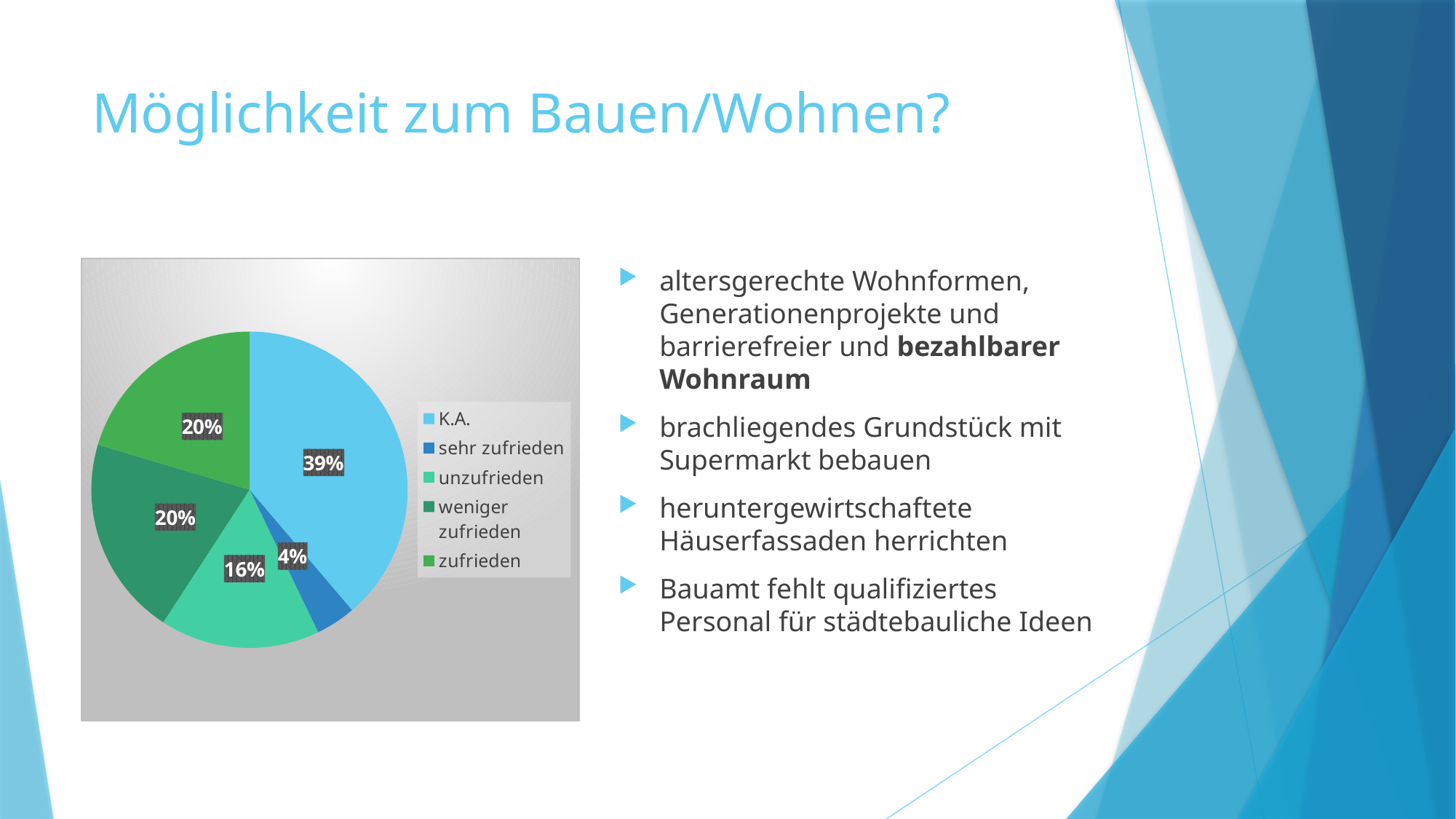
Which category has the largest slice of the pie chart? K.A. Which slice is larger, 'unzufrieden' or 'sehr zufrieden'? unzufrieden How many categories does the pie chart legend list? 5 What type of chart is shown on the slide? pie chart What percentage of the pie chart is labelled K.A.? 39% Which category has the smallest slice of the pie chart? sehr zufrieden What percentage is shown for 'weniger zufrieden'? 20% What percentage is shown for 'zufrieden'? 20% What colour is the K.A. slice in the pie chart? light blue What is the difference in percentage points between the K.A. slice and the 'unzufrieden' slice? 23 What is the value shown for 'unzufrieden' in the pie chart? 16% What share of the pie does the 'sehr zufrieden' slice have? 4%